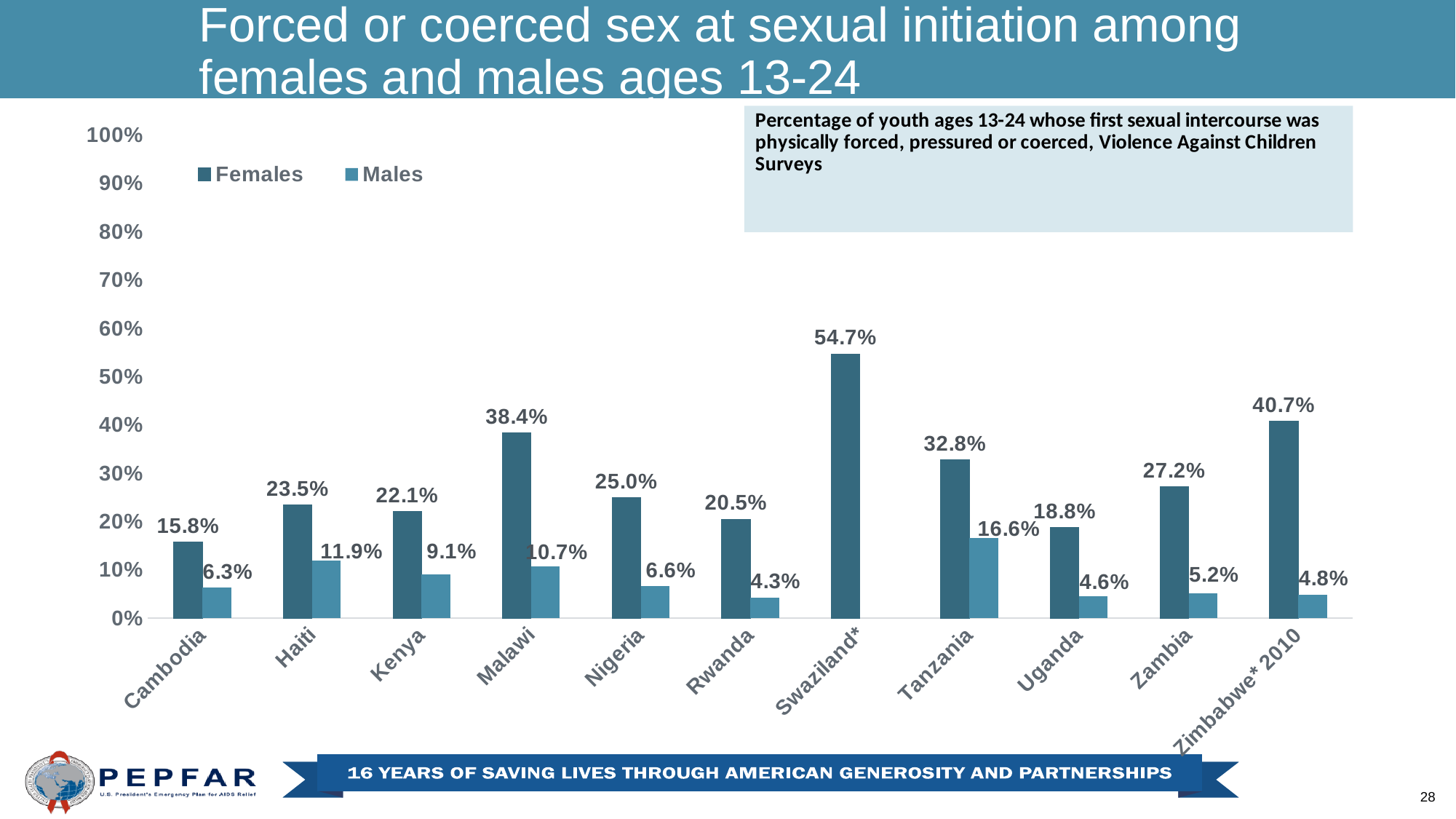
Is the Females value for Zimbabwe* 2010 greater or less than 40%? greater How many countries are shown on the x axis? 11 What kind of chart is shown on the slide? bar chart Which is larger, the Females value for Zambia or the Females value for Tanzania? Tanzania How many series does the legend list? 2 Which country has the lowest Males value? Rwanda What is the difference between the Females and Males values for Malawi? 27.7% What is the Females value for Cambodia? 15.8% What is the Females value for Swaziland*? 54.7% What is the Males value for Tanzania? 16.6% Which country has the highest Females value? Swaziland* What are the two series named in the legend? Females and Males